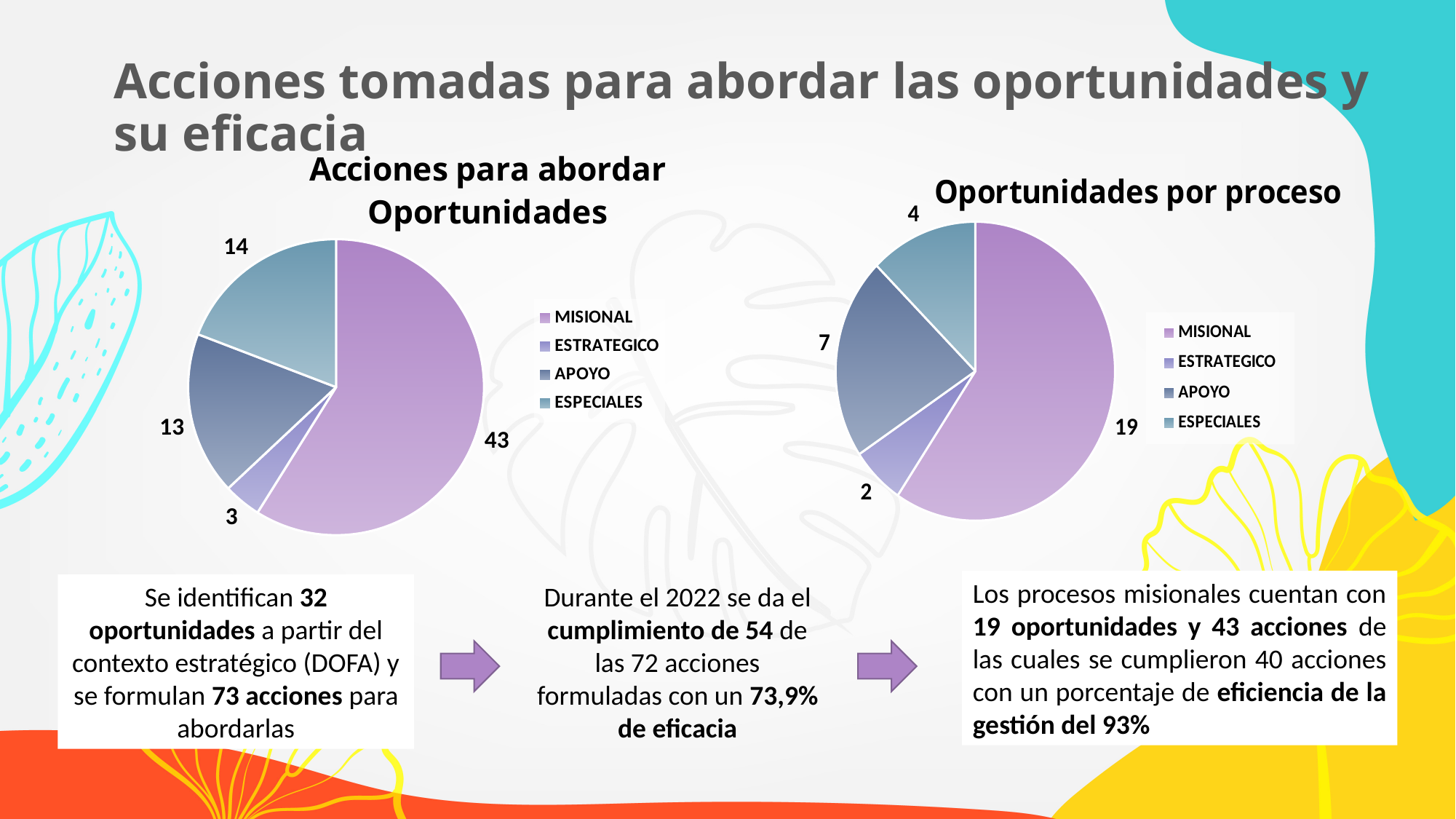
In the "Acciones para abordar Oportunidades" chart, what is the value for ESPECIALES? 14 In the "Oportunidades por proceso" chart, which is larger, APOYO or ESPECIALES? APOYO In the "Acciones para abordar Oportunidades" chart, what is the value for MISIONAL? 43 In the "Acciones para abordar Oportunidades" chart, what is the difference between the APOYO and ESTRATEGICO values? 10 What type of chart is "Acciones para abordar Oportunidades"? Pie chart In the "Oportunidades por proceso" chart, what is the total of all slices? 32 In the "Acciones para abordar Oportunidades" chart, which category has the smallest slice? ESTRATEGICO In the "Acciones para abordar Oportunidades" chart, what colour is the MISIONAL slice? Purple In the "Acciones para abordar Oportunidades" chart, how many categories does the legend list? 4 In the "Oportunidades por proceso" chart, what is the value for APOYO? 7 In the "Oportunidades por proceso" chart, which category has the largest slice? MISIONAL In the "Oportunidades por proceso" chart, what is the value for ESTRATEGICO? 2